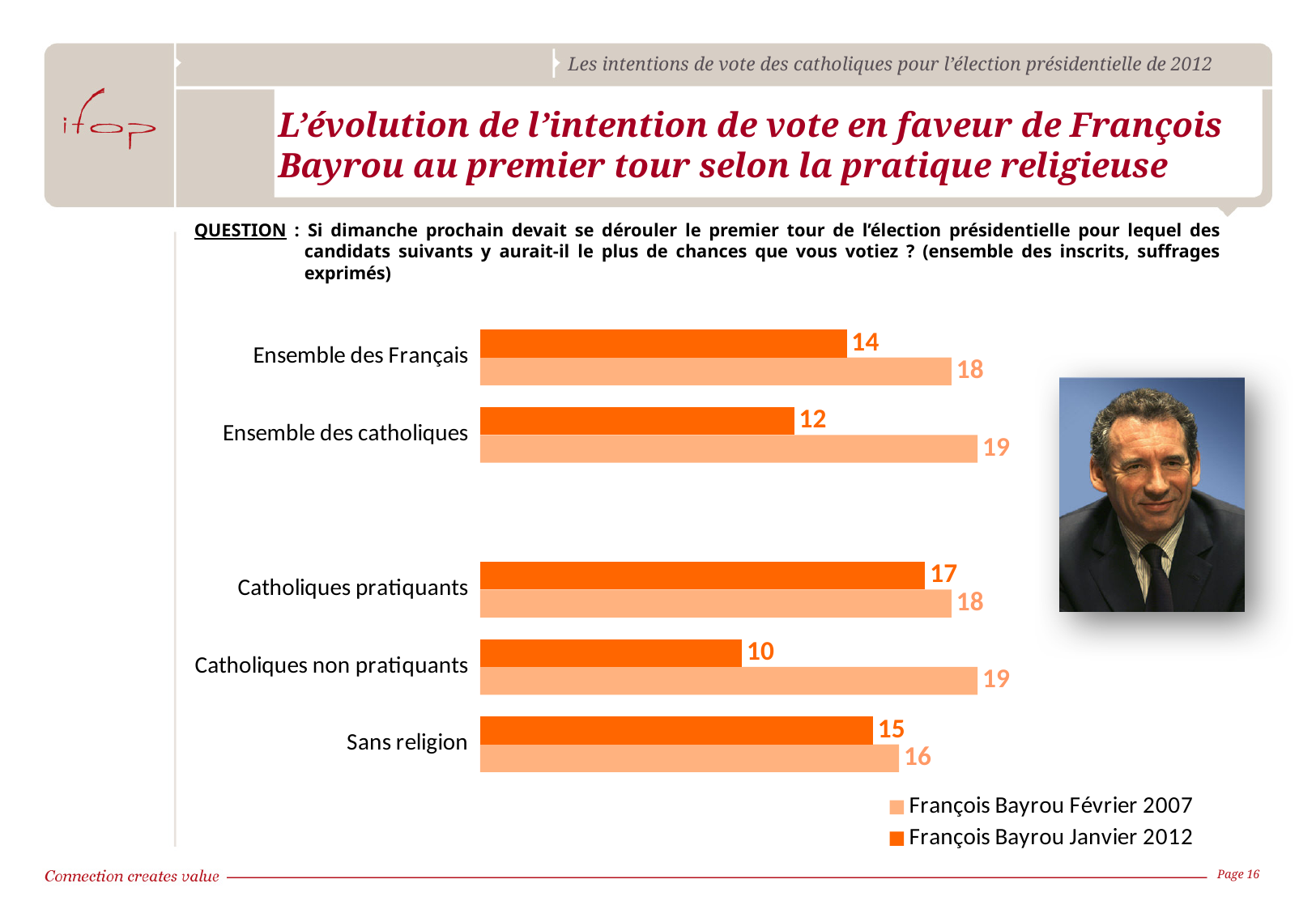
How many series does the legend list? 2 How many categories are shown on the chart? 5 Which category has the lowest value in the François Bayrou Février 2007 series? Sans religion What is the value for Ensemble des catholiques in the François Bayrou Février 2007 series? 19 For Ensemble des catholiques, which is larger: the Février 2007 value or the Janvier 2012 value? François Bayrou Février 2007 What is the value for Catholiques non pratiquants in the François Bayrou Janvier 2012 series? 10 What is the difference between the Février 2007 and Janvier 2012 values for Catholiques non pratiquants? 9 What is the value for Ensemble des Français in the François Bayrou Janvier 2012 series? 14 Which category has the highest value in the François Bayrou Janvier 2012 series? Catholiques pratiquants What kind of chart is shown on the slide? Bar chart Which category has the lowest value in the François Bayrou Janvier 2012 series? Catholiques non pratiquants What is the value for Sans religion in the François Bayrou Février 2007 series? 16